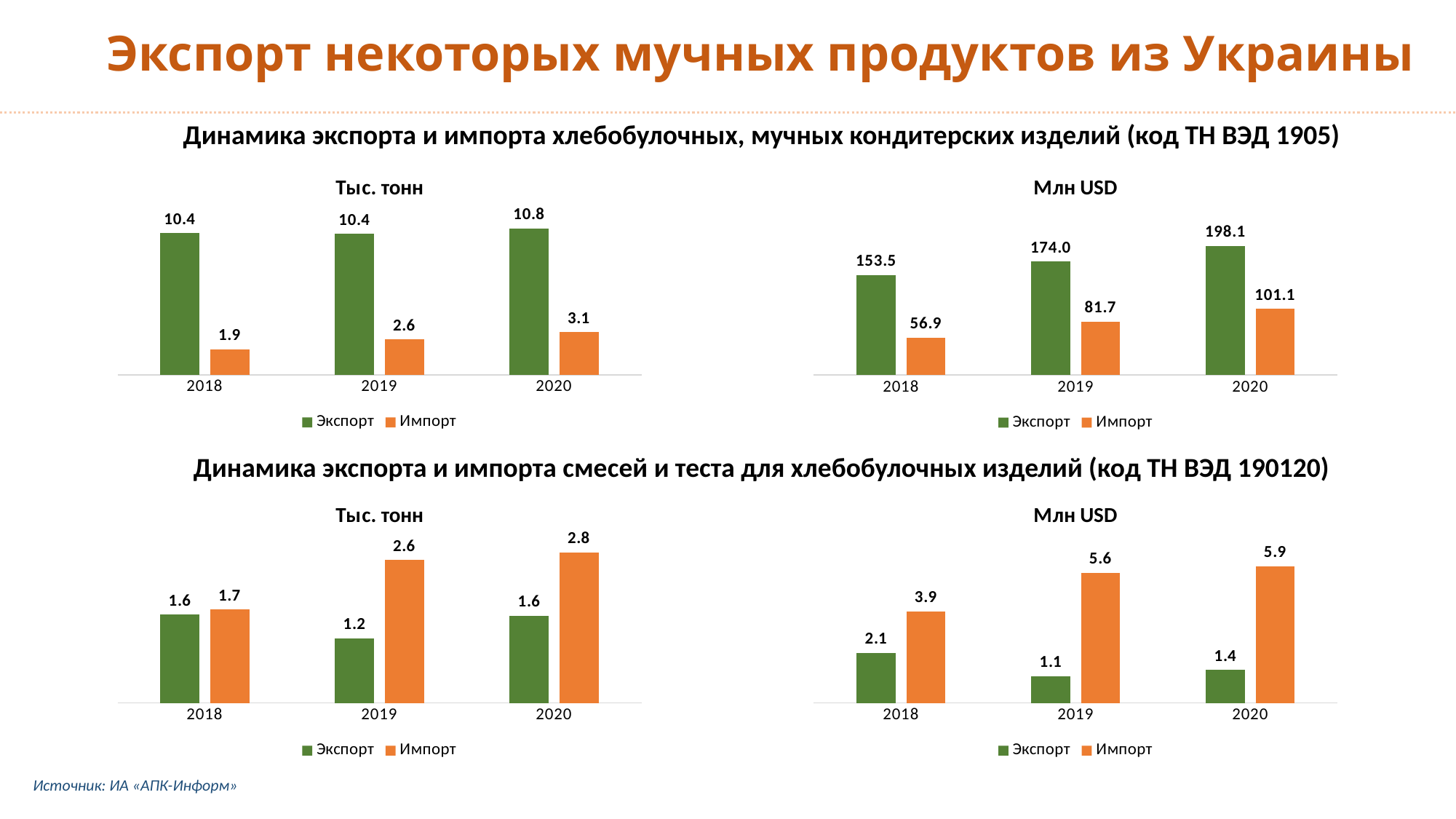
In the top-left chart (Тыс. тонн, код ТН ВЭД 1905), what is the Экспорт value for 2020? 10.8 In the bottom-right chart (Млн USD, код ТН ВЭД 190120), which year has the lowest Экспорт value? 2019 In the top-right chart (Млн USD, код ТН ВЭД 1905), what is the Импорт value for 2019? 81.7 In the top-left chart (Тыс. тонн, код ТН ВЭД 1905), does the Импорт value rise or fall from 2018 to 2020? Rise In the bottom-right chart (Млн USD, код ТН ВЭД 190120), what is the difference between the Импорт values for 2020 and 2018? 2.0 How many series does the legend of the top-left chart (Тыс. тонн, код ТН ВЭД 1905) list? 2 In the top-right chart (Млн USD, код ТН ВЭД 1905), which year has the highest Экспорт value? 2020 Which colour represents Импорт in the charts on the slide? Orange In the bottom-left chart (Тыс. тонн, код ТН ВЭД 190120), how many years are shown on the x axis? 3 In the top-right chart (Млн USD, код ТН ВЭД 1905), what is the difference between the Экспорт and Импорт values for 2020? 97.0 What type of chart is the bottom-right chart (Млн USD, код ТН ВЭД 190120)? Bar chart In the bottom-left chart (Тыс. тонн, код ТН ВЭД 190120), which is larger in 2019: Экспорт or Импорт? Импорт